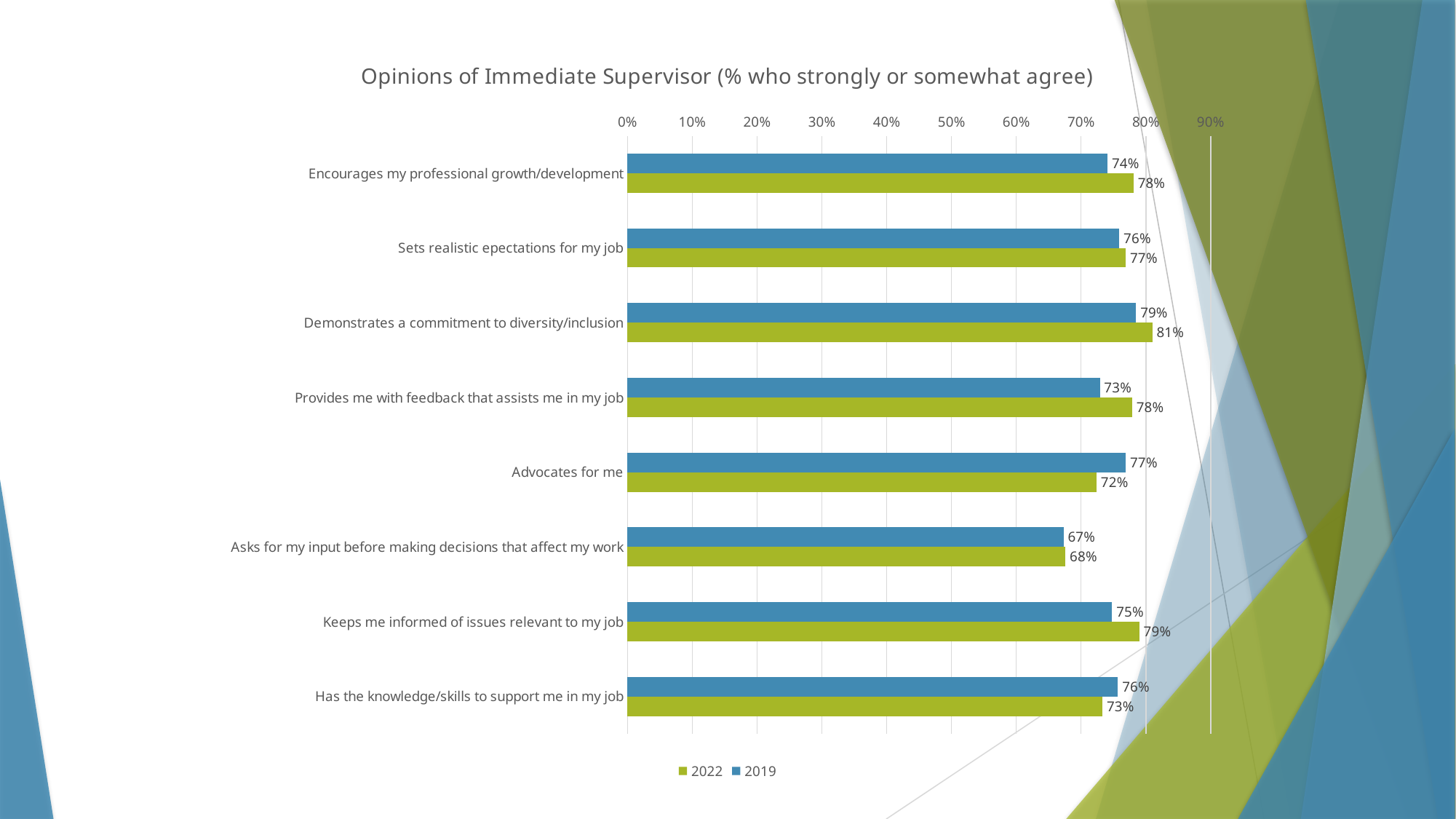
Which category has the highest 2022 value? Demonstrates a commitment to diversity/inclusion What is the title of the chart? Opinions of Immediate Supervisor (% who strongly or somewhat agree) Which category has the lowest 2019 value? Asks for my input before making decisions that affect my work What is the 2019 value for "Asks for my input before making decisions that affect my work"? 67% What is the difference between the 2022 and 2019 values for "Provides me with feedback that assists me in my job"? 5% How many categories are shown on the chart? 8 Is the 2022 value for "Keeps me informed of issues relevant to my job" greater or less than 70%? greater How many series does the legend list? 2 What is the 2019 value for "Advocates for me"? 77% What kind of chart is shown on the slide? Bar chart For "Has the knowledge/skills to support me in my job", which year has the larger value, 2022 or 2019? 2019 What is the 2022 value for "Demonstrates a commitment to diversity/inclusion"? 81%